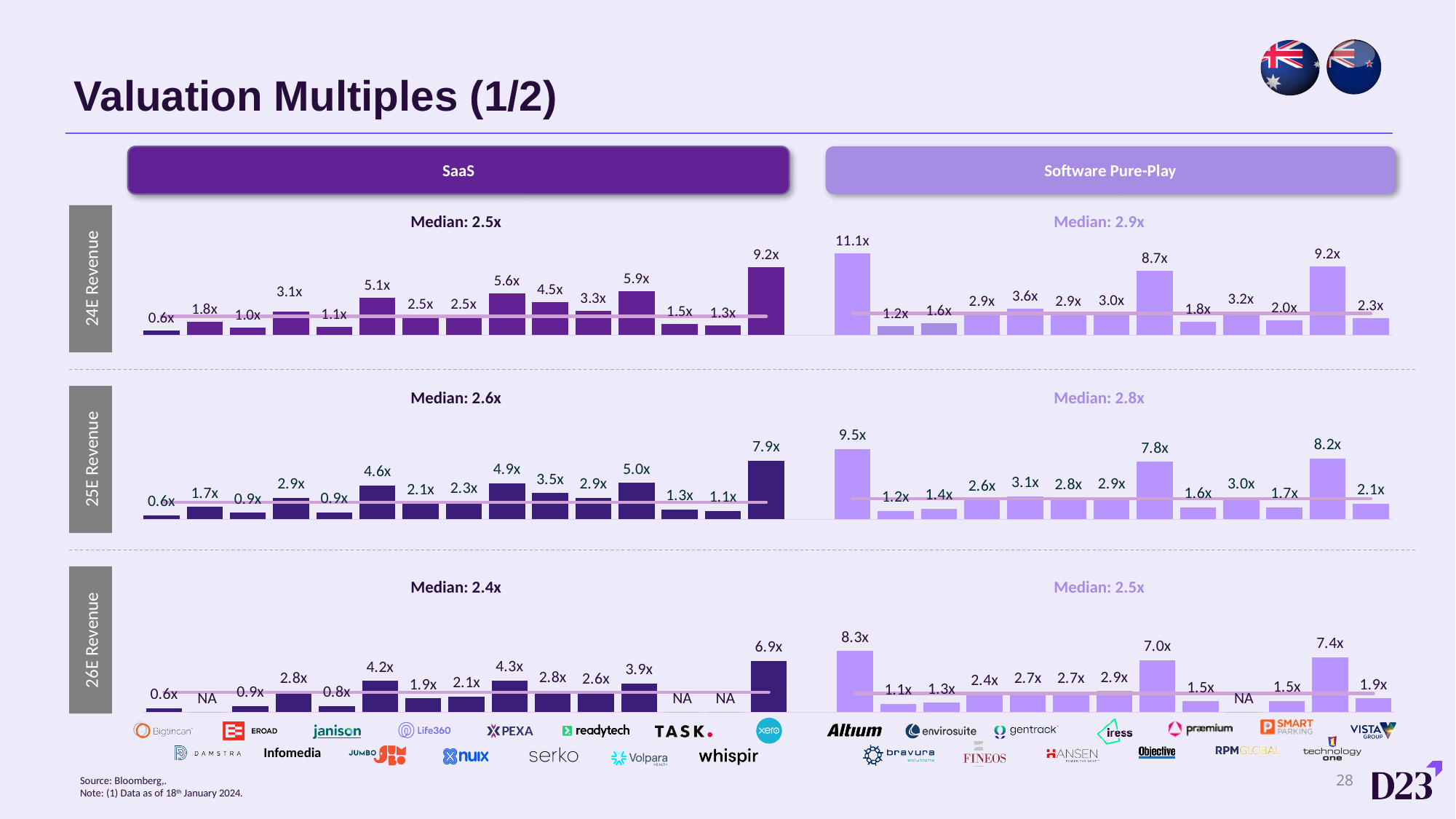
What is the median shown for the SaaS 25E Revenue chart? 2.6x What is the median shown for the Software Pure-Play 26E Revenue chart? 2.5x What type of chart is used for the 26E Revenue valuation multiples? Bar chart In the SaaS 24E Revenue chart, what is the lowest valuation multiple shown? 0.6x In the SaaS 24E Revenue chart, what is the highest valuation multiple shown? 9.2x In the SaaS 25E Revenue chart, what is the highest valuation multiple shown? 7.9x In the Software Pure-Play 24E Revenue chart, what is the highest valuation multiple shown? 11.1x In the Software Pure-Play 24E Revenue chart, what is the lowest valuation multiple shown? 1.2x How many bars are plotted in the SaaS 24E Revenue chart? 15 What is the difference between the highest multiple in the Software Pure-Play 24E Revenue chart and the highest multiple in the SaaS 24E Revenue chart? 1.9x How many bars are plotted in the Software Pure-Play 24E Revenue chart? 13